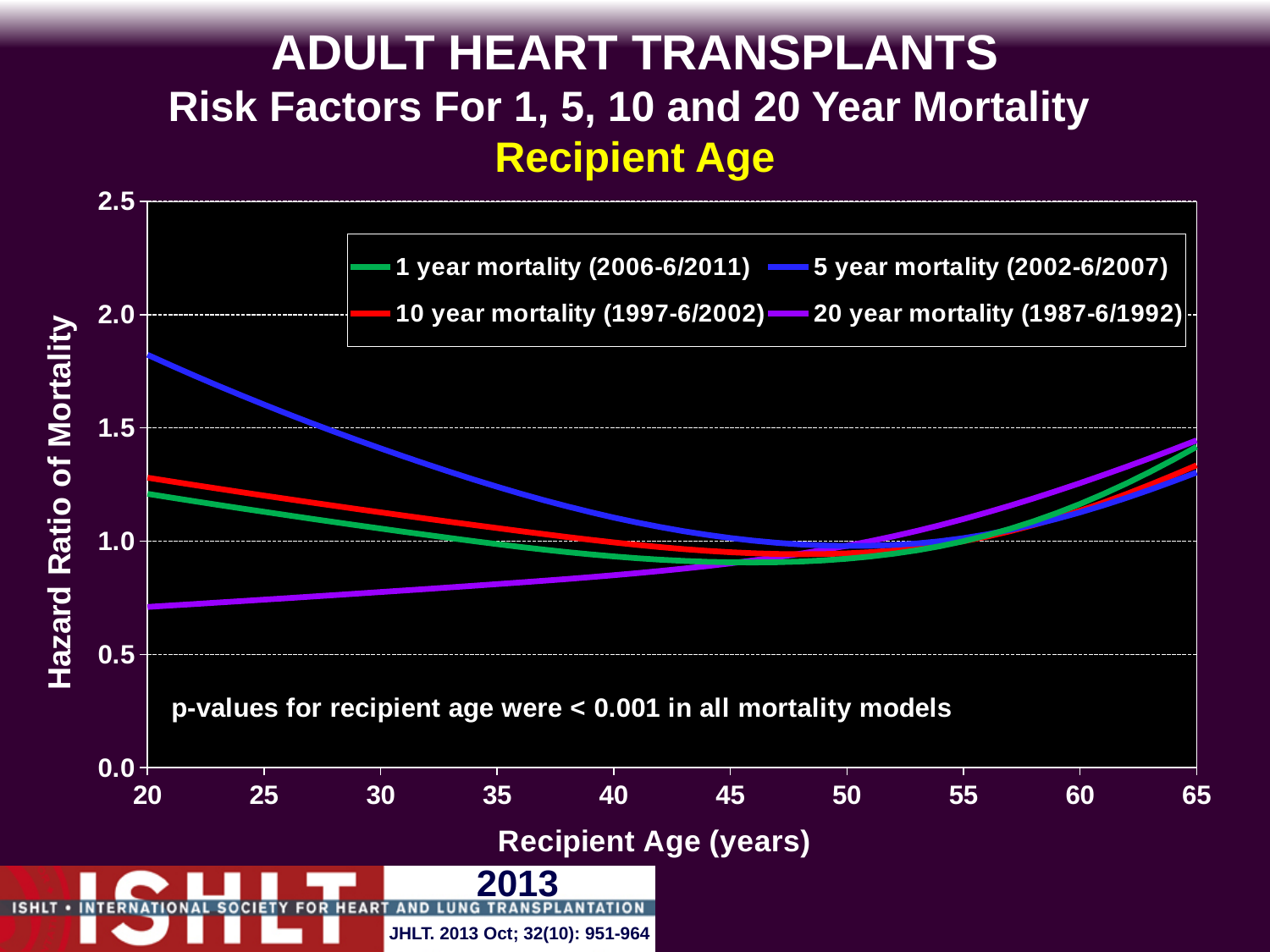
Is the hazard ratio for 5 year mortality at recipient age 20 greater or less than 1.5? greater How many series does the legend list? 4 Is the hazard ratio for 1 year mortality at recipient age 20 greater or less than 1.0? greater Is the hazard ratio for 20 year mortality at recipient age 20 greater or less than 1.0? less Does the hazard ratio for 5 year mortality rise or fall as recipient age increases from 20 to 45? fall At recipient age 30, which is higher: the hazard ratio for 5 year mortality or for 20 year mortality? 5 year mortality Does the hazard ratio for 20 year mortality rise or fall as recipient age increases from 20 to 65? rise Which series has the highest hazard ratio of mortality at recipient age 20? 5 year mortality (2002-6/2007) What is the label of the y axis? Hazard Ratio of Mortality Which series has the lowest hazard ratio of mortality at recipient age 20? 20 year mortality (1987-6/1992) What kind of chart is shown on the slide? line chart